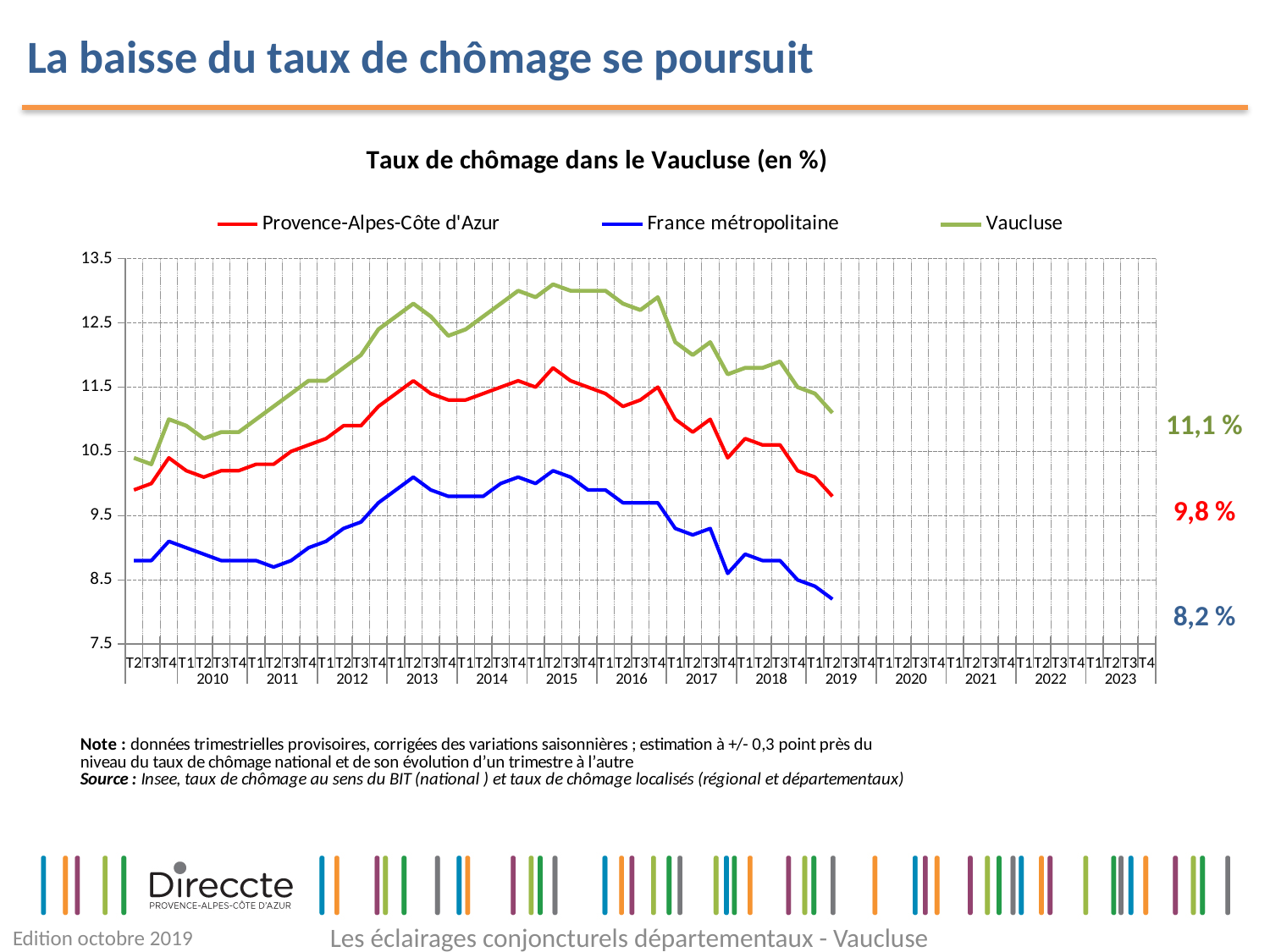
How many series does the legend list? 3 Which series has the lowest unemployment rate at the end of the period? France métropolitaine Which series has the highest unemployment rate at the end of the period? Vaucluse Is the peak value of the Vaucluse line in 2015 greater or less than 12.5? greater What is the latest labelled value for Vaucluse? 11,1 % What is the difference between the latest labelled values for Vaucluse and France métropolitaine? 2,9 What kind of chart is shown on the slide? line chart What is the latest labelled value for Provence-Alpes-Côte d'Azur? 9,8 % What is the difference between the latest labelled values for Vaucluse and Provence-Alpes-Côte d'Azur? 1,3 Do the unemployment rates rise or fall between 2016 and 2019? fall What is the latest labelled value for France métropolitaine? 8,2 % What is the title of the chart? Taux de chômage dans le Vaucluse (en %)